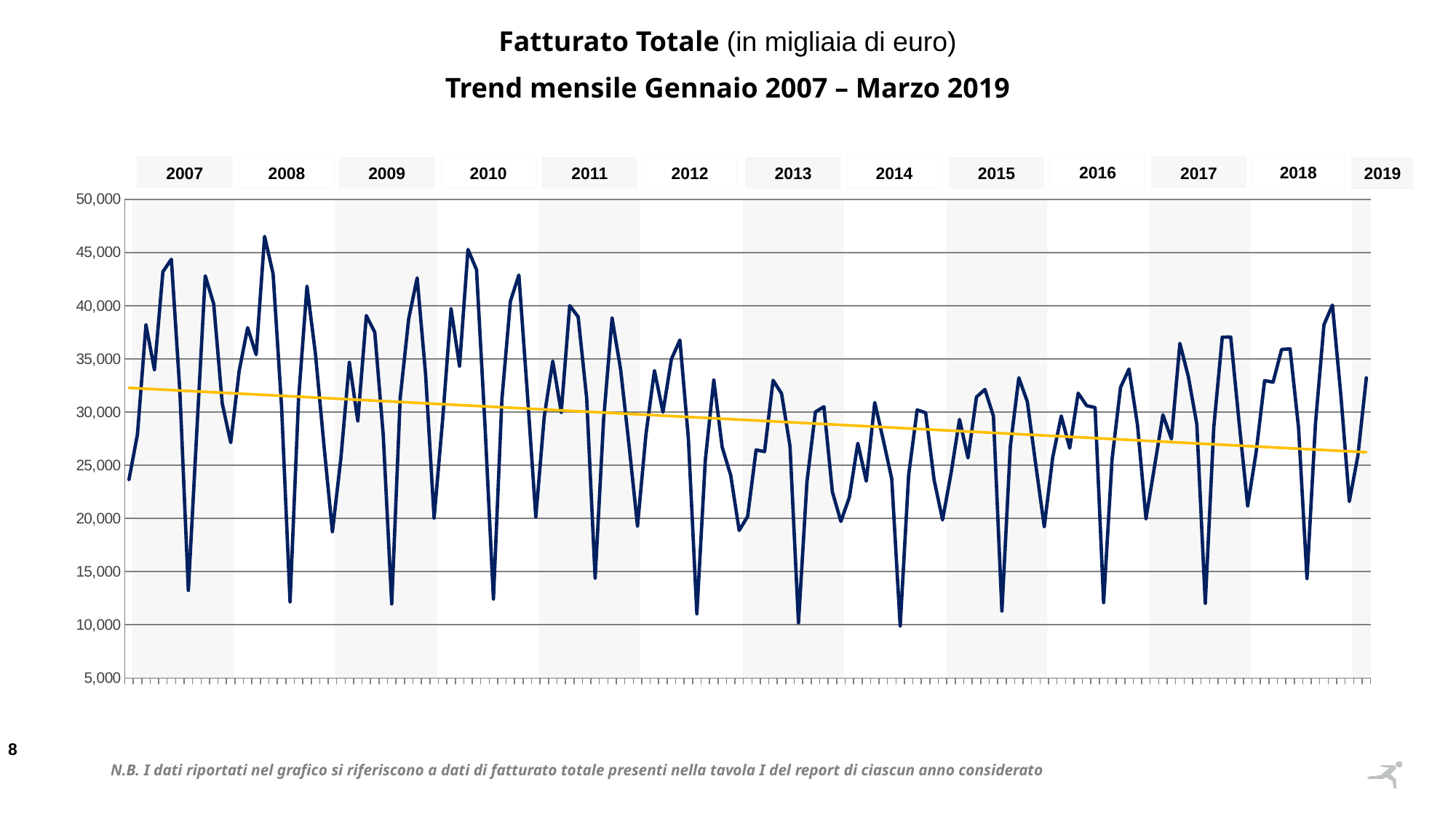
Is the highest monthly value in 2017 greater or less than 35,000? greater What kind of chart is shown on the slide? line chart What period does the chart's subtitle say the monthly trend covers? Gennaio 2007 – Marzo 2019 Is the lowest monthly value in 2008 greater or less than 15,000? less Is the lowest monthly value in 2016 greater or less than 15,000? less According to the yellow trend line, does total revenue rise or fall from 2007 to 2019? fall In which year does the monthly line reach its highest peak? 2008 What is the highest value shown on the vertical axis? 50,000 How many years are labelled along the top of the chart? 13